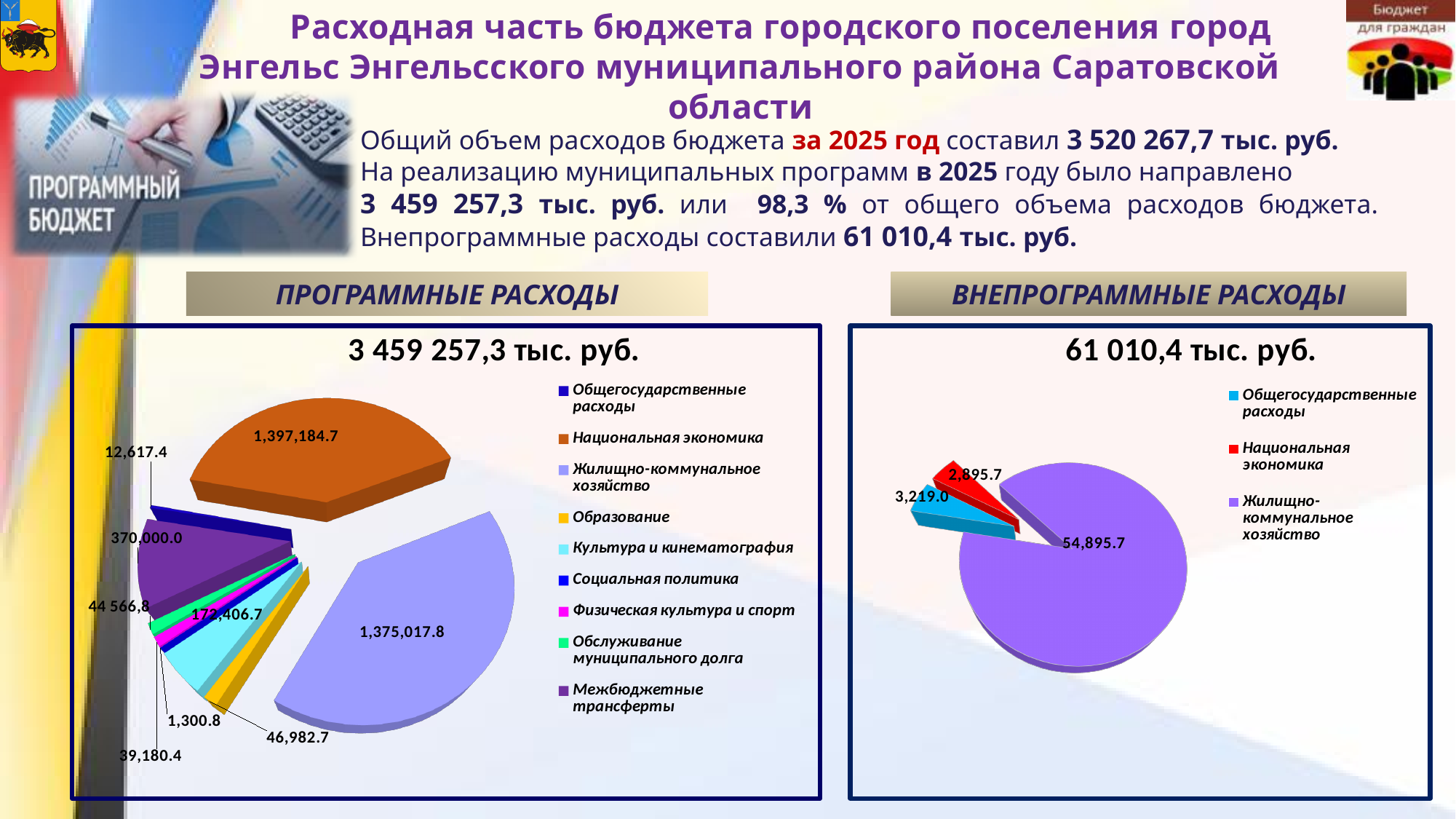
On the left chart (ПРОГРАММНЫЕ РАСХОДЫ), how many categories does the legend list? 9 On the right chart (ВНЕПРОГРАММНЫЕ РАСХОДЫ), what is the difference between Общегосударственные расходы and Национальная экономика? 323.3 On the left chart (ПРОГРАММНЫЕ РАСХОДЫ), which category has the largest slice? Национальная экономика On the right chart (ВНЕПРОГРАММНЫЕ РАСХОДЫ), what is the value for Общегосударственные расходы? 3,219.0 On the left chart (ПРОГРАММНЫЕ РАСХОДЫ), what is the value for Национальная экономика? 1,397,184.7 On the left chart (ПРОГРАММНЫЕ РАСХОДЫ), what is the difference between Национальная экономика and Жилищно-коммунальное хозяйство? 22,166.9 What type of chart is shown on the right (ВНЕПРОГРАММНЫЕ РАСХОДЫ)? Pie chart On the left chart (ПРОГРАММНЫЕ РАСХОДЫ), what is the value for Жилищно-коммунальное хозяйство? 1,375,017.8 On the left chart (ПРОГРАММНЫЕ РАСХОДЫ), what is the value for Культура и кинематография? 172,406.7 On the right chart (ВНЕПРОГРАММНЫЕ РАСХОДЫ), which category has the smallest slice? Национальная экономика On the right chart (ВНЕПРОГРАММНЫЕ РАСХОДЫ), what is the value for Жилищно-коммунальное хозяйство? 54,895.7 On the left chart (ПРОГРАММНЫЕ РАСХОДЫ), what is the value for Межбюджетные трансферты? 370,000.0